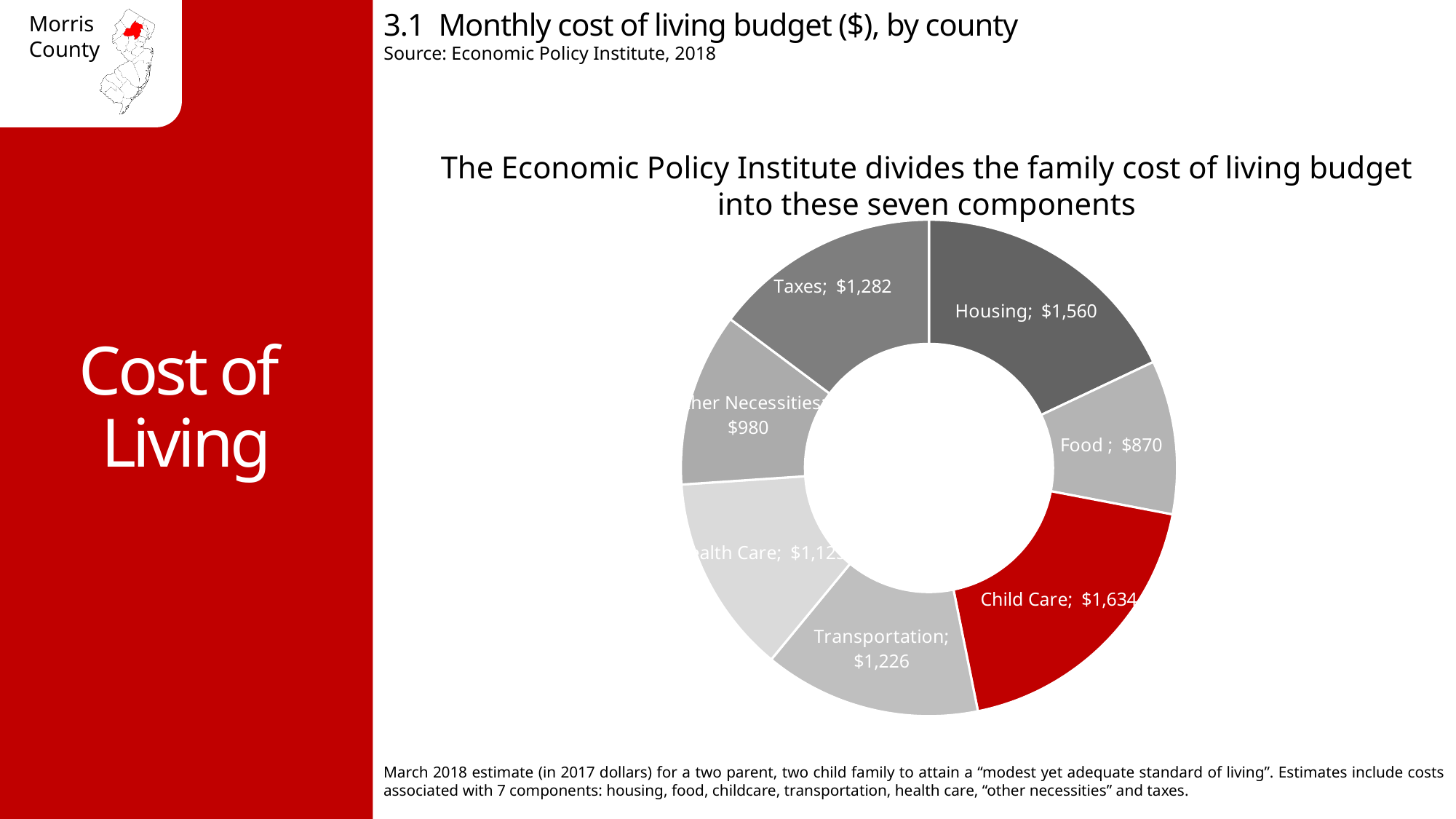
What is the monthly cost for Taxes? $1,282 What type of chart is shown on the slide? Doughnut (pie) chart Which component has the lowest monthly cost? Food What is the monthly cost for Transportation? $1,226 What is the monthly cost for Housing? $1,560 Which is larger, the cost for Taxes or the cost for Other Necessities? Taxes How many components are shown in the chart? 7 Which component has the highest monthly cost? Child Care What is the difference between the Taxes cost and the Transportation cost? $56 What is the monthly cost for Child Care? $1,634 How much more is the Child Care cost than the Housing cost? $74 What is the monthly cost for Food? $870